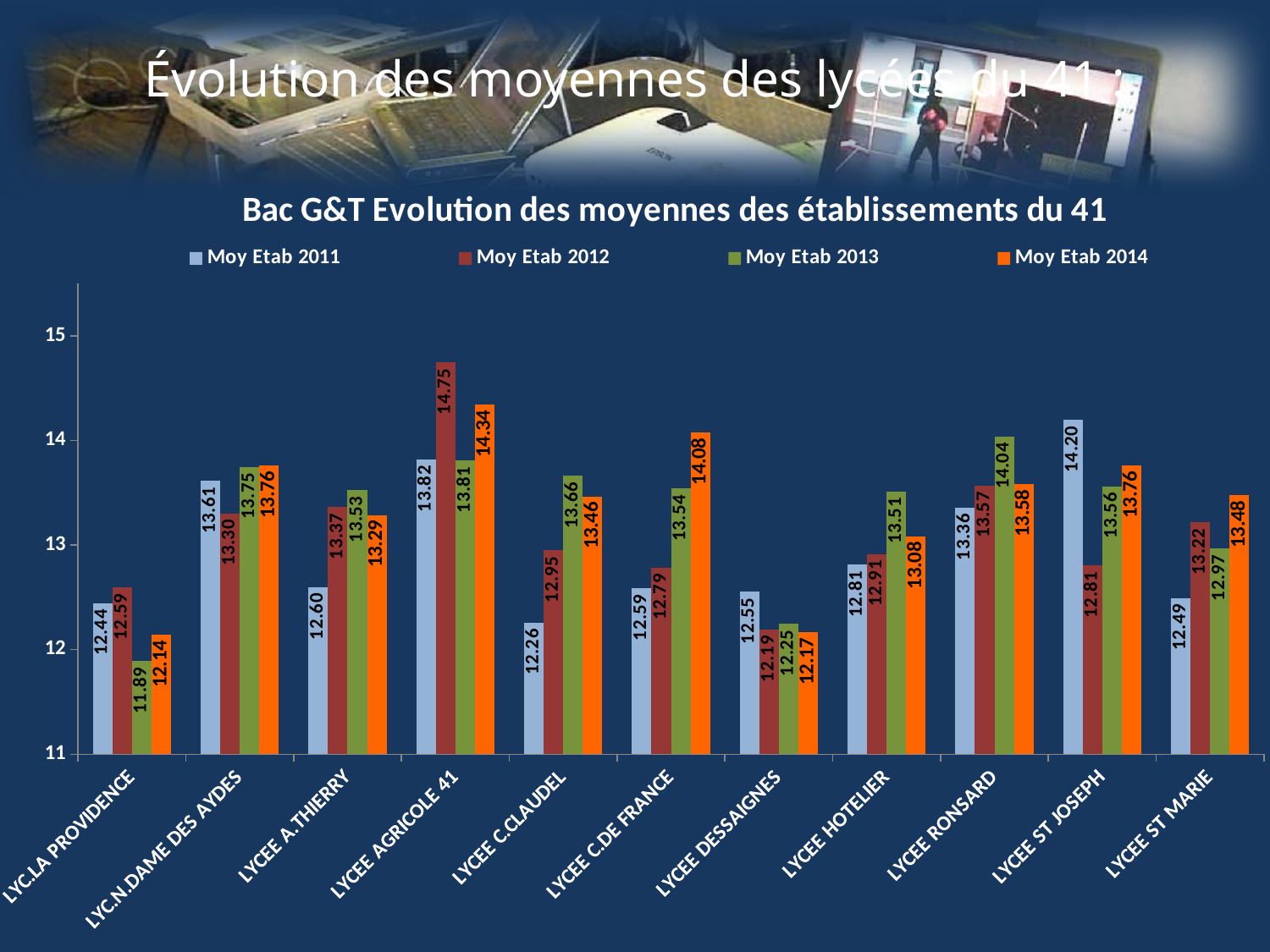
What is the Moy Etab 2011 value for LYCEE ST JOSEPH? 14.20 Is the Moy Etab 2011 value for LYCEE DESSAIGNES greater or less than 13? less Do the values for LYCEE C.DE FRANCE rise or fall from Moy Etab 2011 to Moy Etab 2014? rise What is the Moy Etab 2014 value for LYCEE C.DE FRANCE? 14.08 How many establishments are shown on the x axis? 11 What is the difference between the Moy Etab 2012 and Moy Etab 2011 values for LYCEE AGRICOLE 41? 0.93 Which has the larger Moy Etab 2013 value, LYCEE RONSARD or LYCEE ST JOSEPH? LYCEE RONSARD What kind of chart is shown on the slide? bar chart Which establishment has the highest Moy Etab 2012 value? LYCEE AGRICOLE 41 Which establishment has the lowest Moy Etab 2013 value? LYC.LA PROVIDENCE How many series does the legend list? 4 What is the title of the chart? Bac G&T Evolution des moyennes des établissements du 41